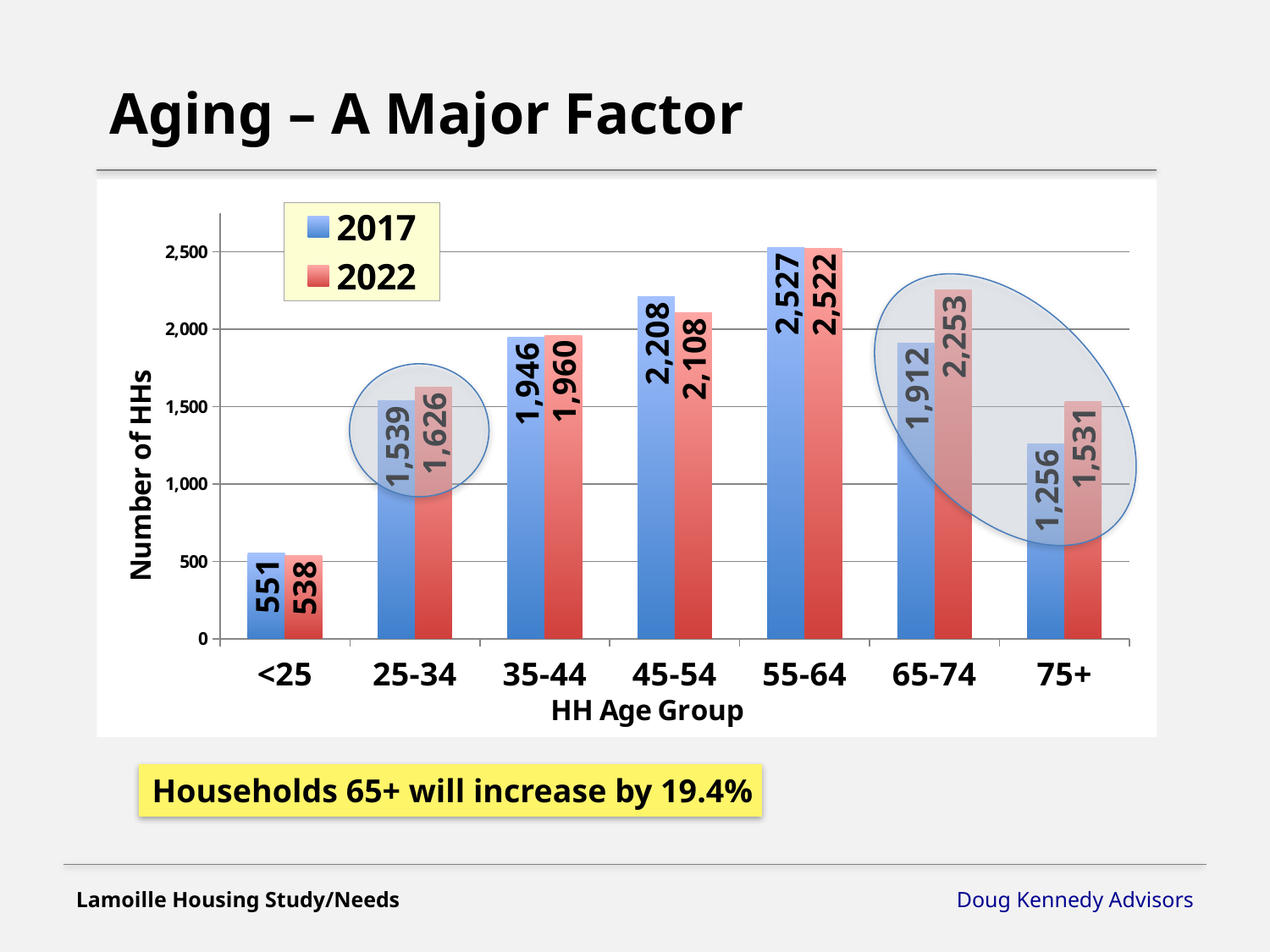
What is the difference between the 2017 and 2022 values for the 45-54 age group? 100 Which age group has the lowest 2022 value? <25 For the 75+ age group, which is larger: the 2017 value or the 2022 value? 2022 What is the difference between the 2022 and 2017 values for the 65-74 age group? 341 What is the 2022 value for the 75+ age group? 1,531 How many series does the legend list? 2 Which age group has the highest 2017 value? 55-64 How many age groups are shown on the x axis? 7 What is the 2017 value for the 65-74 age group? 1,912 What kind of chart is shown on the slide? bar chart Is the 2017 value for the 35-44 age group greater or less than 2,000? less What is the 2022 value for the 25-34 age group? 1,626